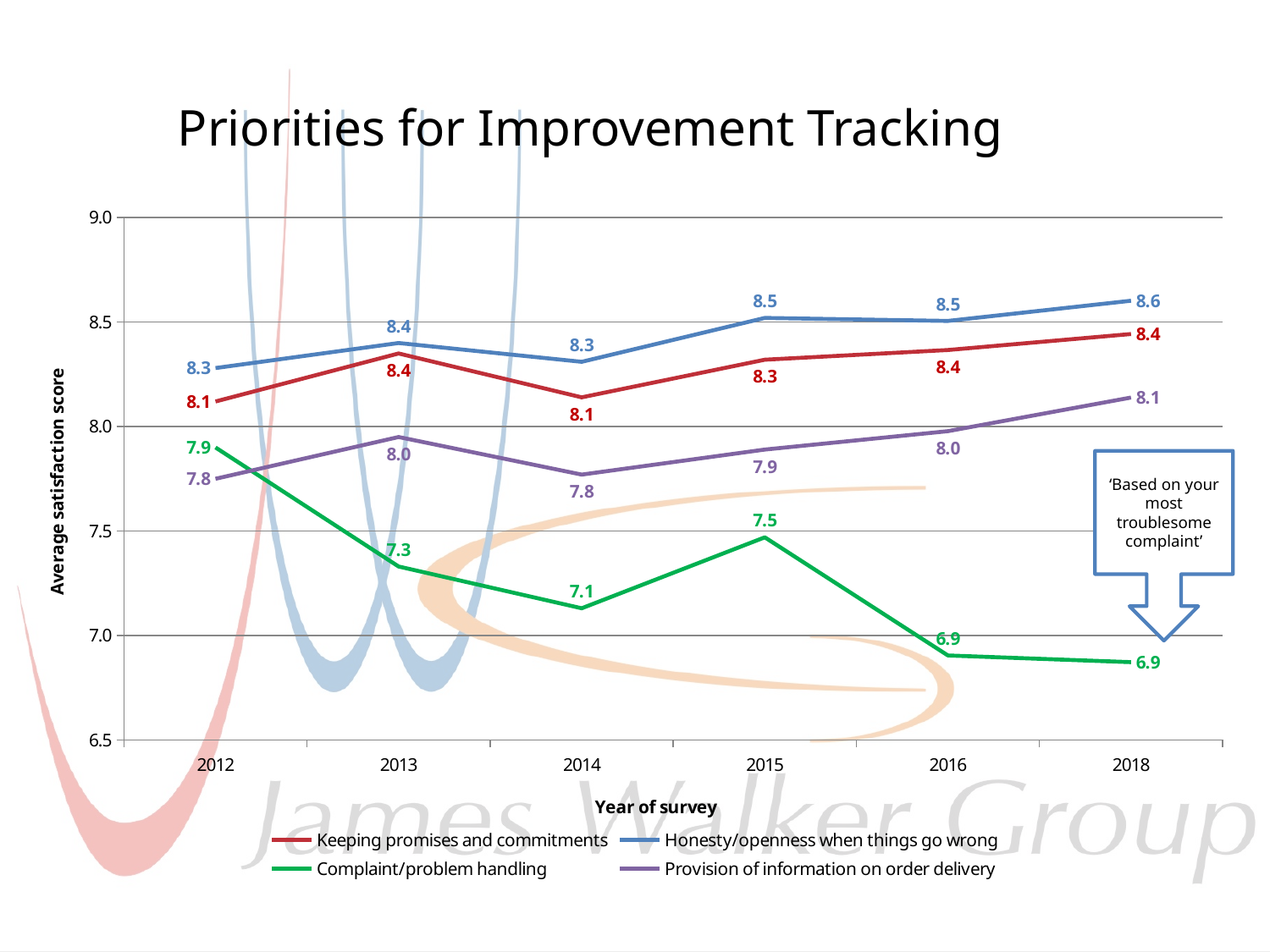
What kind of chart is shown on the slide? Line chart What is the title of the chart's x axis? Year of survey What is the difference between the Honesty/openness when things go wrong score and the Complaint/problem handling score in 2018? 1.7 Which series has the lowest score in 2016? Complaint/problem handling Which is higher in 2015: Keeping promises and commitments or Provision of information on order delivery? Keeping promises and commitments What is the average satisfaction score for Complaint/problem handling in 2014? 7.1 In which year does Complaint/problem handling reach its highest score? 2012 What is the average satisfaction score for Provision of information on order delivery in 2012? 7.8 What is the average satisfaction score for Honesty/openness when things go wrong in 2018? 8.6 How many years of survey are plotted along the x axis? 6 How many series does the legend list? 4 Does the Complaint/problem handling score generally rise or fall from 2012 to 2018? Fall